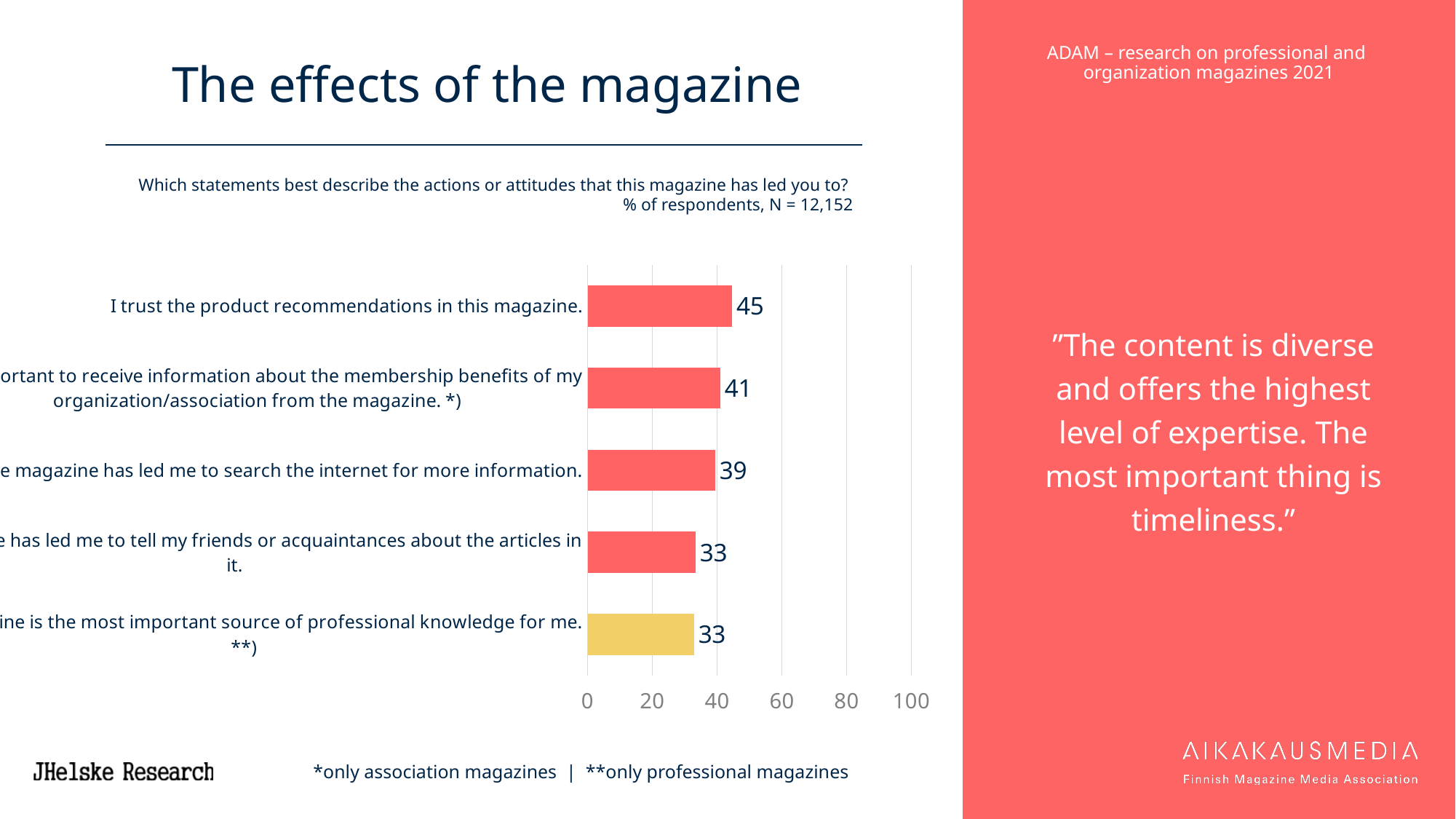
How many statements (bars) are shown in the chart? 5 What value is shown for the statement about receiving information about membership benefits of the organization/association from the magazine? 41 Which bar is coloured differently (yellow) from the others? The magazine is the most important source of professional knowledge for me. **) What value is shown for the statement about the magazine leading respondents to search the internet for more information? 39 What is the difference between the value for trusting product recommendations and the value for searching the internet for more information? 6 Which statement has the highest value in the chart? I trust the product recommendations in this magazine. What is the sample size (N) stated in the chart subtitle? 12,152 Is the value for trusting product recommendations greater or less than 40? greater What percentage of respondents say they trust the product recommendations in this magazine? 45 What type of chart is shown on the slide? Bar chart Which is larger: the value for receiving information about membership benefits or the value for telling friends about the articles? Receiving information about membership benefits What value is shown for the statement that the magazine is the most important source of professional knowledge? 33